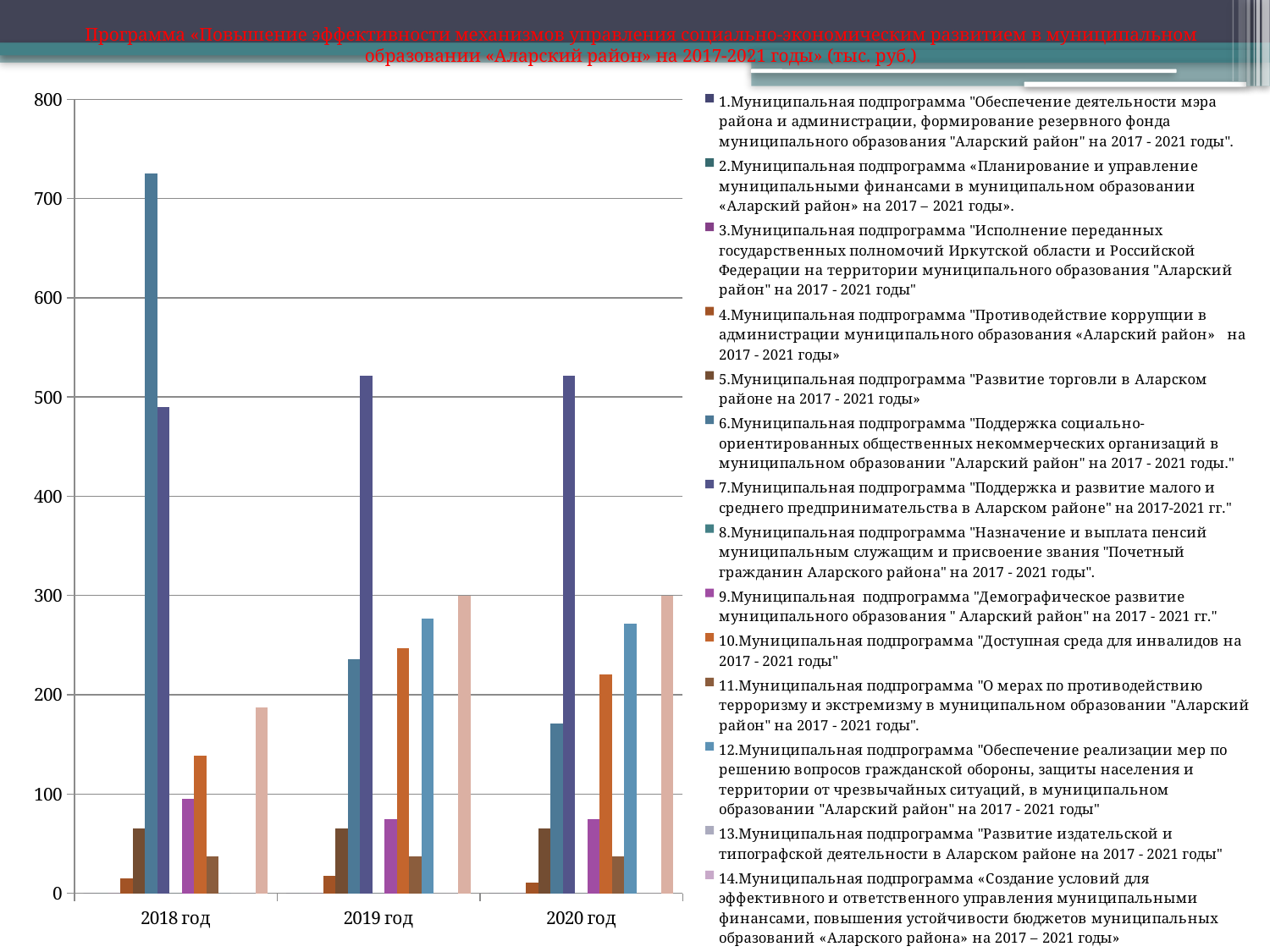
Which year category contains the tallest bar in the chart? 2018 год Is the value of the pink (rightmost) bar in the 2018 год group greater or less than 200? less Is the value of the light blue bar in the 2019 год group greater or less than 200? greater What is the highest value shown on the chart's vertical axis? 800 What kind of chart is shown on the slide? bar chart In what units are the values in the chart expressed, according to the slide title? тыс. руб. How many year categories are shown on the x axis of the chart? 3 Is the value of the tallest bar in the 2019 год group greater or less than 500? greater Which is larger: the tallest bar in 2018 год or the tallest bar in 2019 год? 2018 год How many series does the chart's legend list? 14